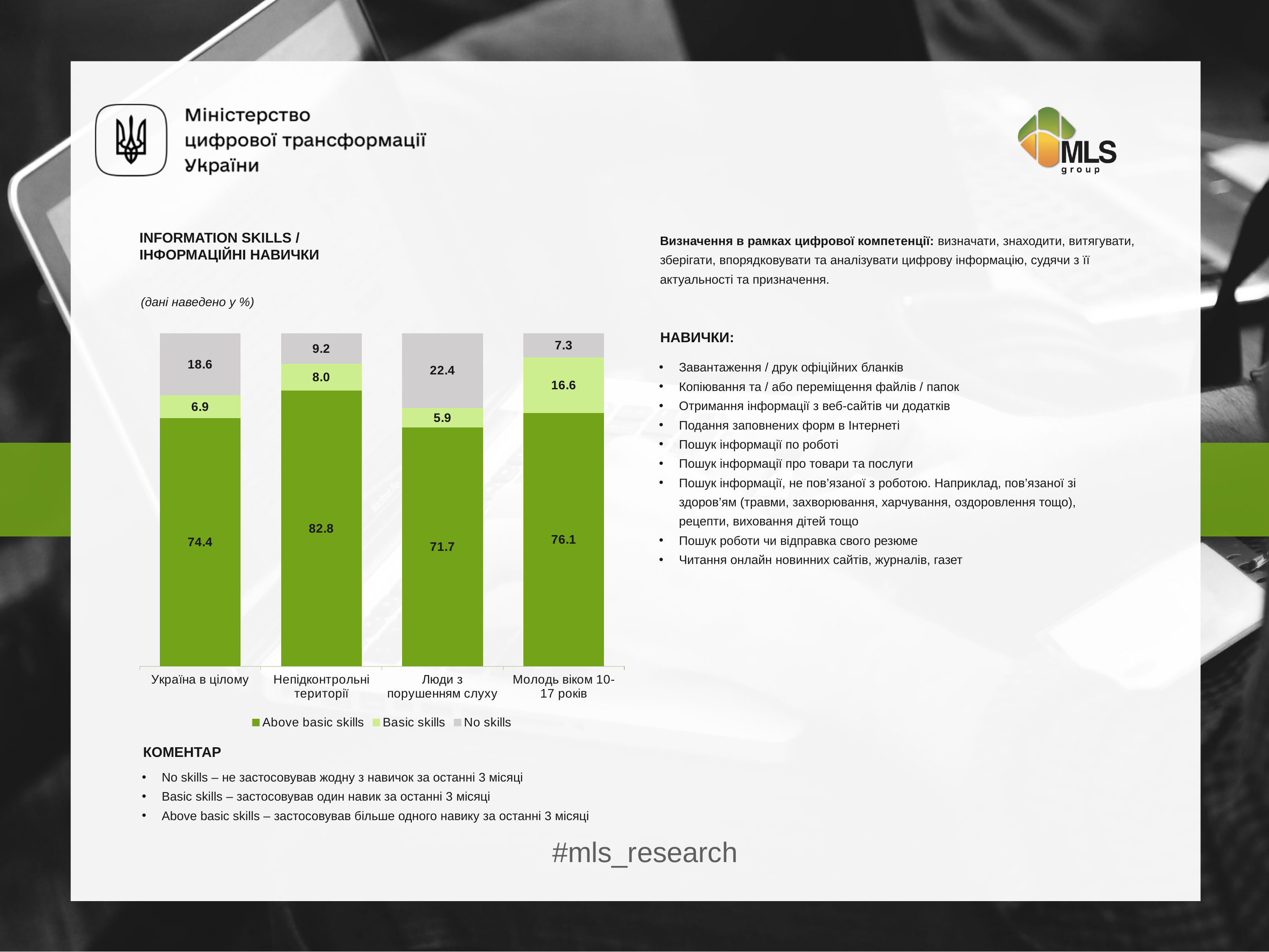
What is the 'No skills' value for Люди з порушенням слуху? 22.4 Which is larger: the 'No skills' value for Україна в цілому or for Непідконтрольні території? Україна в цілому How many categories are shown on the x axis of the chart? 4 Which category has the highest 'Above basic skills' value? Непідконтрольні території What kind of chart is shown on the slide? Stacked bar chart What is the 'Above basic skills' value for Непідконтрольні території? 82.8 Which category has the lowest 'No skills' value? Молодь віком 10-17 років What is the 'Basic skills' value for Молодь віком 10-17 років? 16.6 Which series is shown in dark green in the chart? Above basic skills What is the difference between the 'Above basic skills' values for Непідконтрольні території and Люди з порушенням слуху? 11.1 What is the total of the stacked bar for Молодь віком 10-17 років? 100.0 How many series does the chart legend list? 3